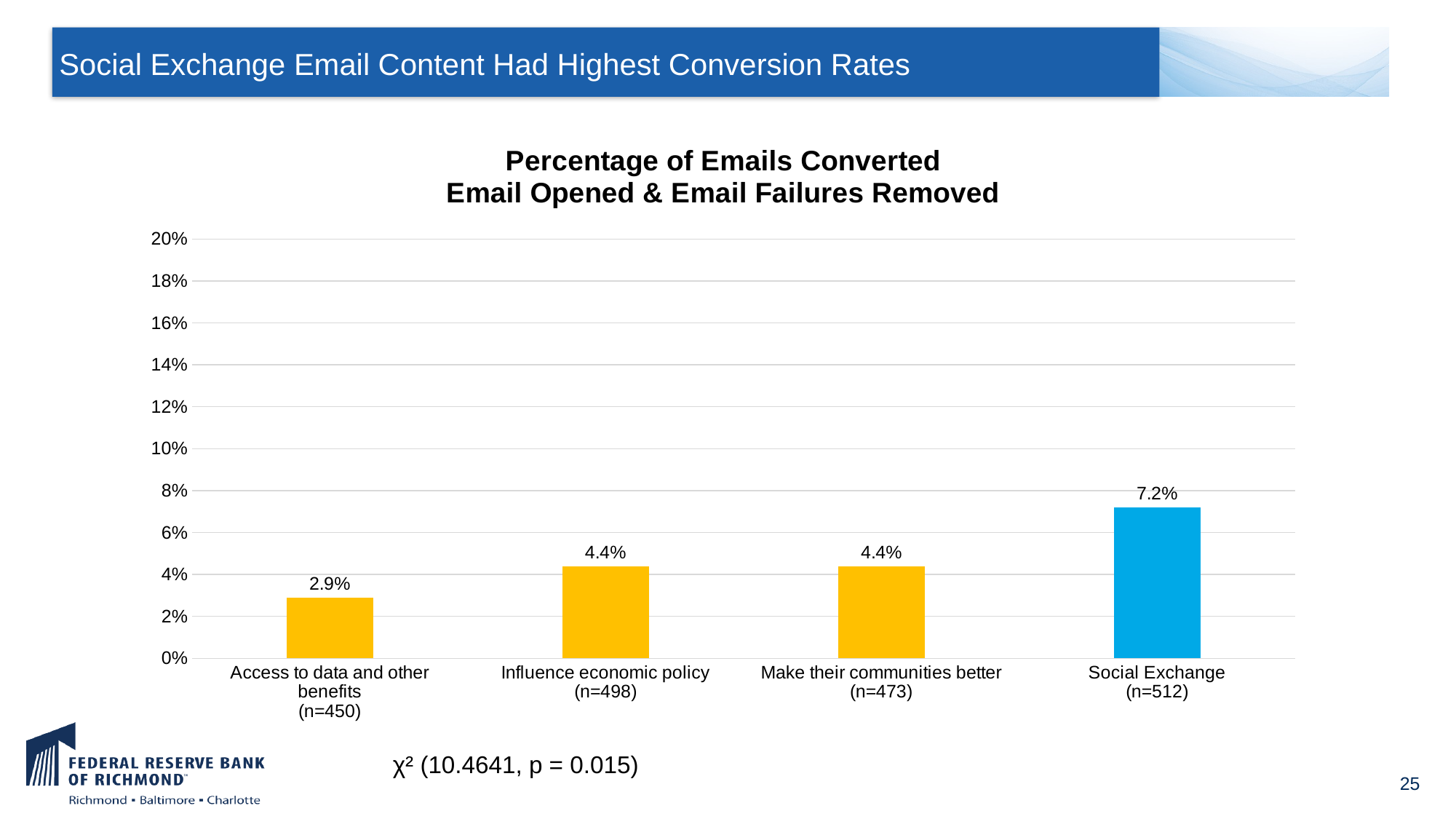
Which email content category has the highest conversion rate? Social Exchange Which email content category has the lowest conversion rate? Access to data and other benefits What is the conversion rate for Access to data and other benefits (n=450)? 2.9% What is the difference between the conversion rates for Social Exchange and Access to data and other benefits? 4.3% Is the conversion rate for Social Exchange greater or less than 6%? greater What is the conversion rate for Social Exchange (n=512)? 7.2% Which has a higher conversion rate, Social Exchange or Influence economic policy? Social Exchange How many email content categories are shown in the chart? 4 What is the difference between the conversion rates for Social Exchange and Make their communities better? 2.8% What is the conversion rate for Influence economic policy (n=498)? 4.4% What is the title of the chart? Percentage of Emails Converted Email Opened & Email Failures Removed What type of chart is shown on the slide? Bar chart